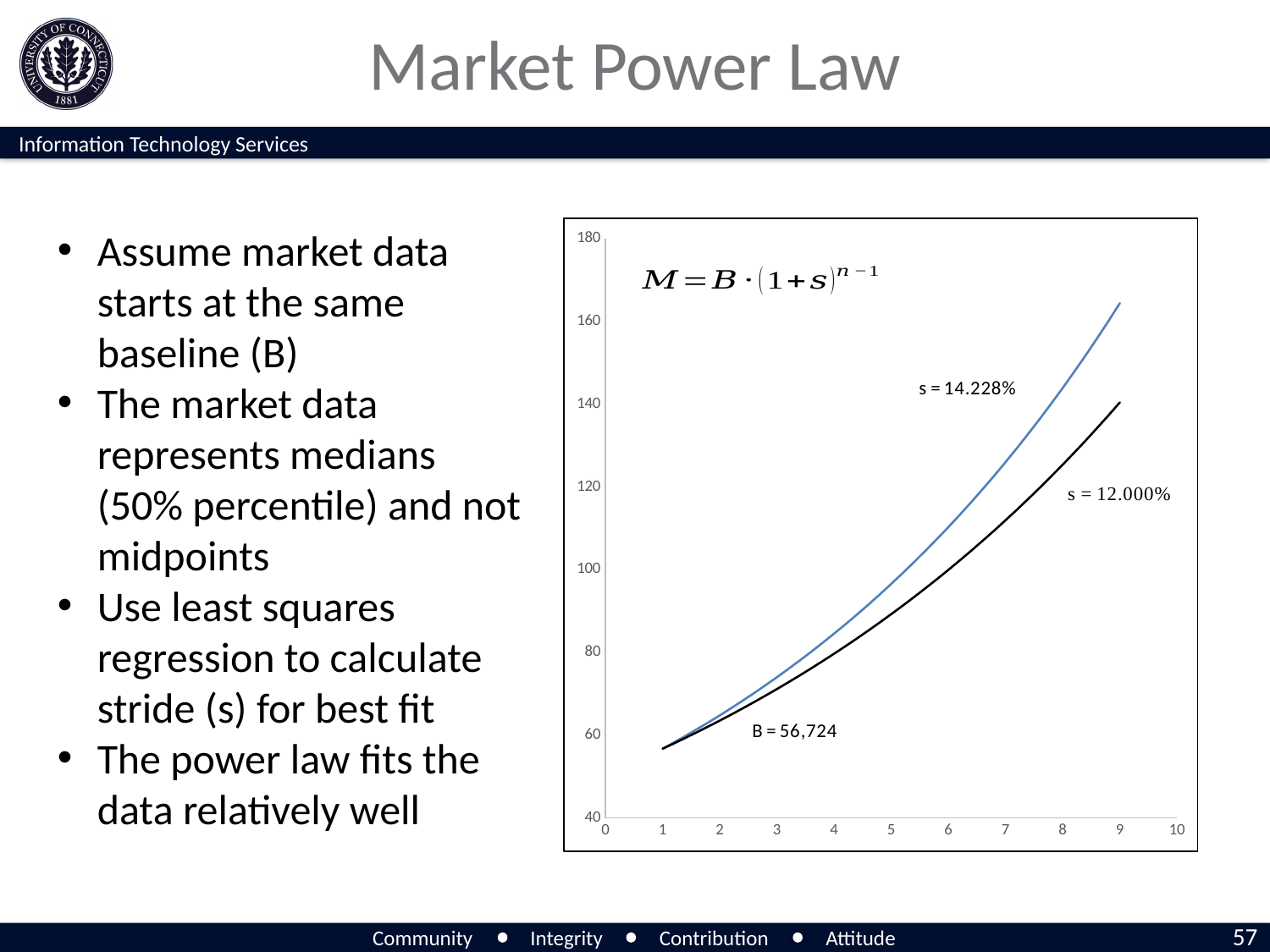
Is the value of the s = 12.000% curve at x = 9 greater or less than 120? greater What is the highest value shown on the y axis? 180 How many curves are plotted on the chart? 2 What kind of chart is shown on the slide? line chart Do the plotted values rise or fall as the x axis increases? rise What formula is written on the chart? M = B · (1 + s)^(n − 1) Is the value of the s = 14.228% curve at x = 5 greater or less than 100? less What stride value (s) is labelled on the lower (black) curve? s = 12.000% Is the value of the s = 14.228% curve at x = 9 greater or less than 160? greater What stride value (s) is labelled on the upper (blue) curve? s = 14.228% What baseline value B is annotated on the chart? B = 56,724 At x = 9, which curve has the higher value, the one with s = 14.228% or the one with s = 12.000%? s = 14.228%